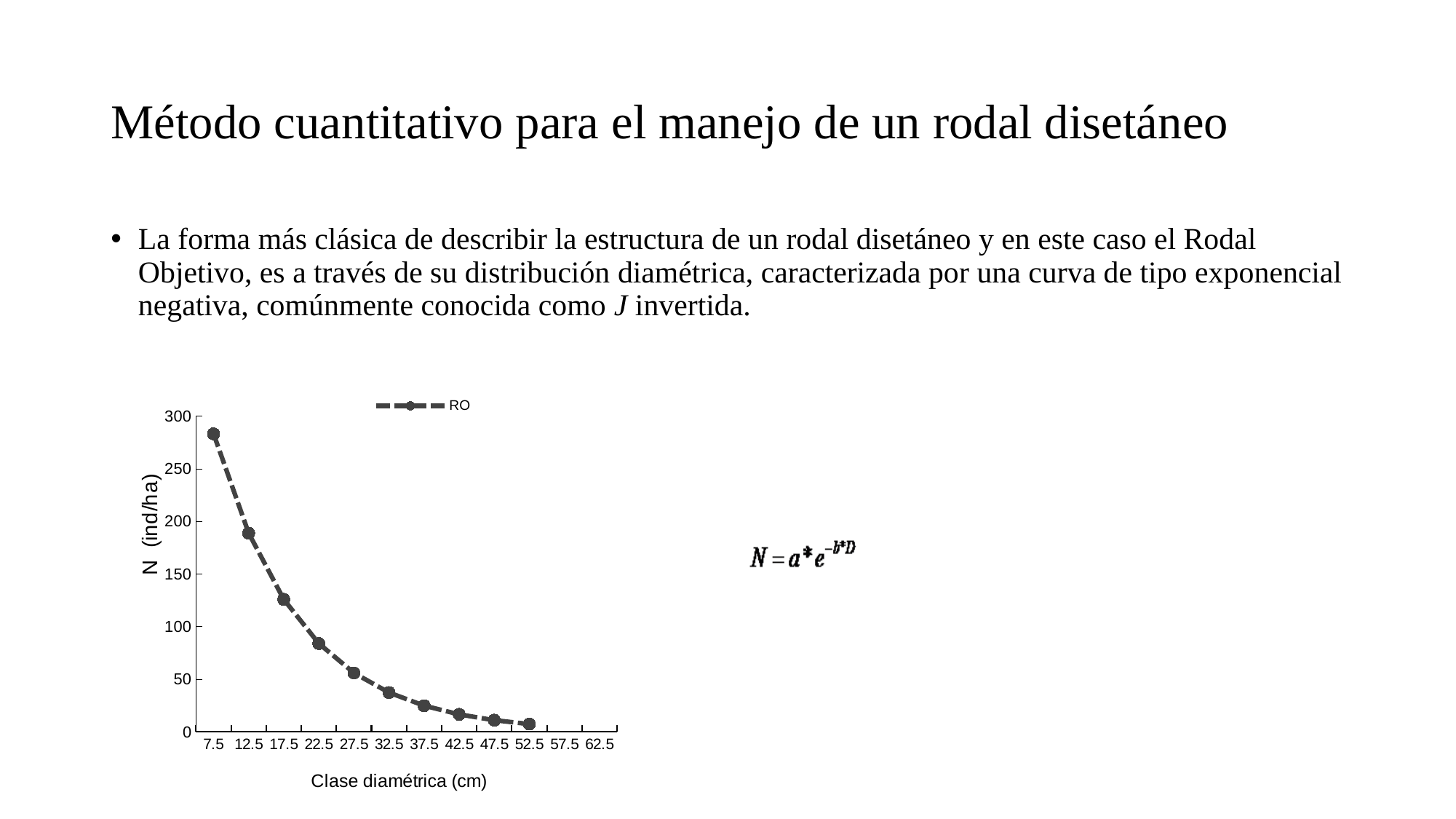
Is the value for diameter class 12.5 greater or less than 200? less Do the values rise or fall as the diameter class increases along the x axis? fall Which diameter class has the highest value of N? 7.5 Is the value for diameter class 22.5 greater or less than 100? less What is the name of the series shown in the legend? RO What is the label of the x axis? Clase diamétrica (cm) What kind of chart is shown on the slide? line chart How many series does the legend list? 1 Is the value for diameter class 7.5 greater or less than 250? greater Which has a larger value, diameter class 12.5 or diameter class 22.5? 12.5 How many data points are plotted on the RO line? 10 Which diameter class has the lowest value of N among the plotted points? 52.5